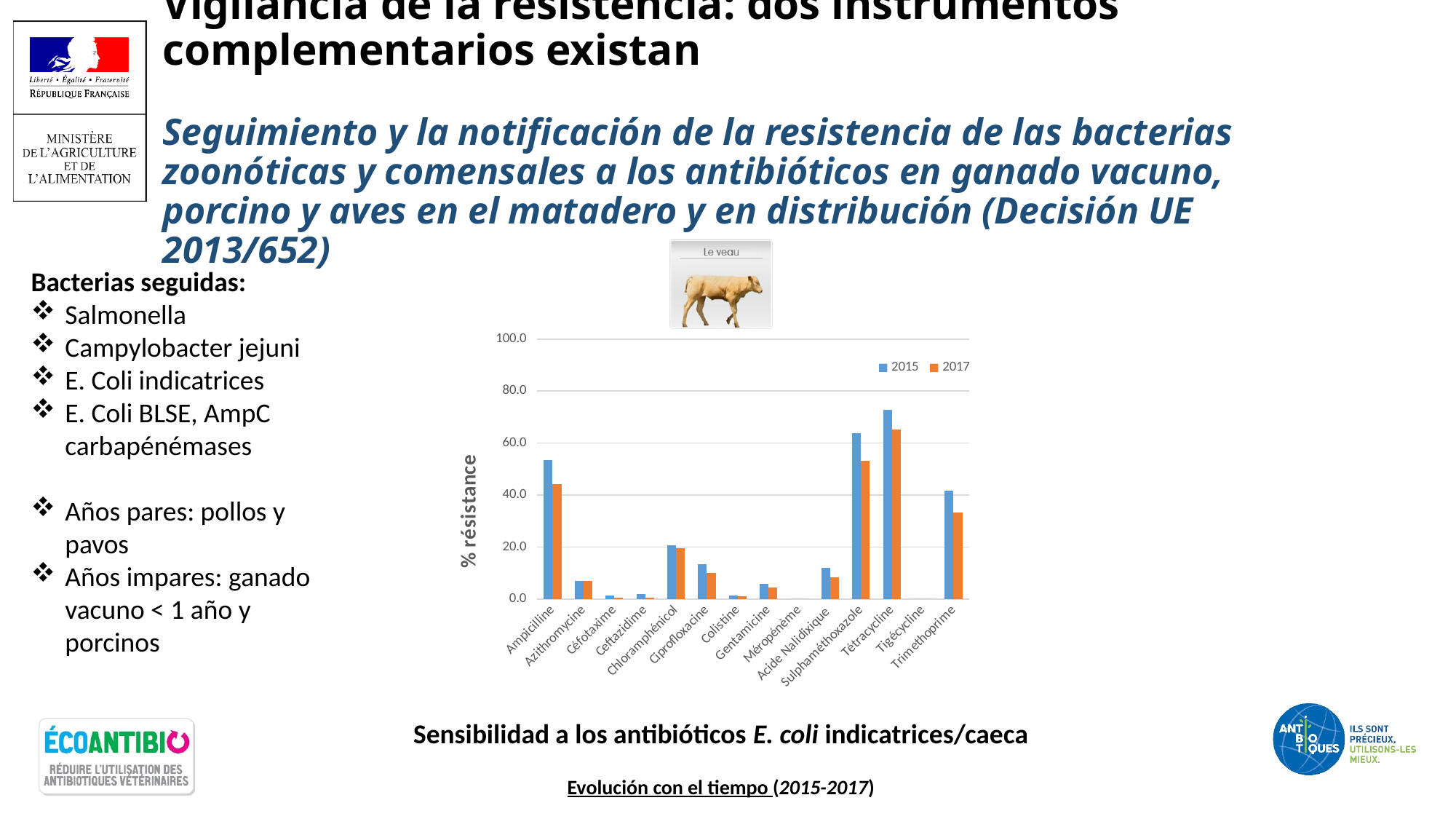
Which antibiotic has the highest resistance value for 2017? Tétracycline Which antibiotic has the highest resistance value for 2015? Tétracycline Is the 2015 value for Tétracycline greater or less than 60.0? greater Is the 2015 value for Sulphaméthoxazole greater or less than 60.0? greater For Ampicilline, which year has the larger resistance value, 2015 or 2017? 2015 Which years are listed in the chart legend? 2015 and 2017 What kind of chart is shown on the slide? bar chart What is the label of the vertical axis of the chart? % résistance How many antibiotic categories are shown on the x axis of the chart? 14 Is the 2017 value for Trimethoprime greater or less than 40.0? less How many series does the chart legend list? 2